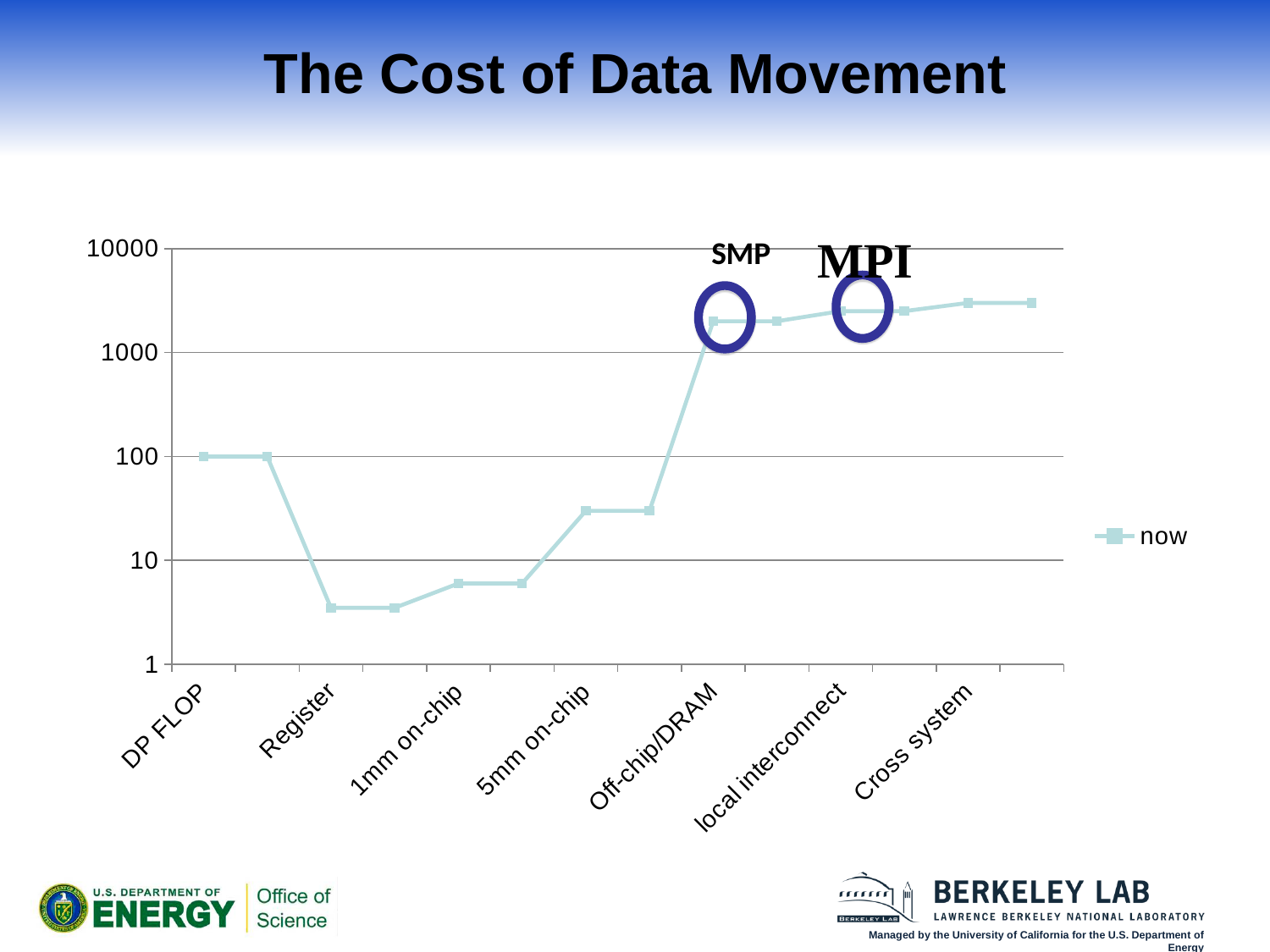
Which labeled category has the highest value? Cross system How many category labels are shown on the x axis? 7 Which labeled category has the lowest value? Register Is the value for Register greater or less than 10? less Is the value for 5mm on-chip greater or less than 100? less Is the value for Off-chip/DRAM greater or less than 1000? greater What is the title of the chart on the slide? The Cost of Data Movement Which is larger, the value for Off-chip/DRAM or the value for Register? Off-chip/DRAM How many series does the legend list? 1 What is the name of the series shown in the legend? now What kind of chart is shown on the slide? line chart Do the values rise or fall along the x axis from Register to Cross system? rise